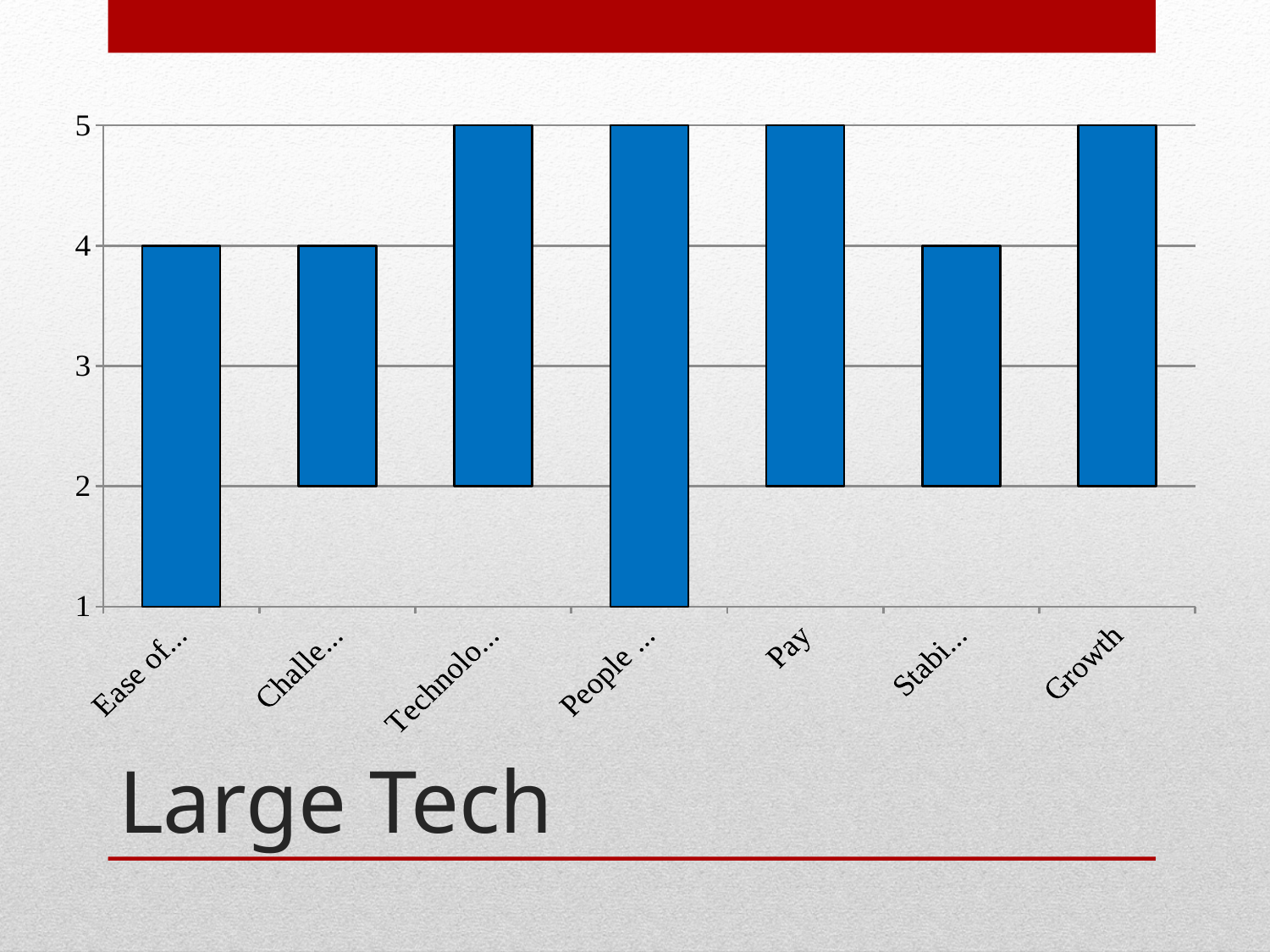
What is the highest value shown on the vertical axis? 5 What value does the top of the first bar from the left reach? 4 What kind of chart is shown on the slide? bar chart What value does the top of the Pay bar reach? 5 How many bars are plotted in the chart? 7 What is the title shown beneath the chart? Large Tech What value does the bottom of the first bar from the left start at? 1 What value does the top of the Growth bar reach? 5 What value does the bottom of the Growth bar start at? 2 Is the top of the Growth bar greater or less than 4? greater What is the difference between the top and bottom of the Pay bar? 3 What value does the bottom of the Pay bar start at? 2